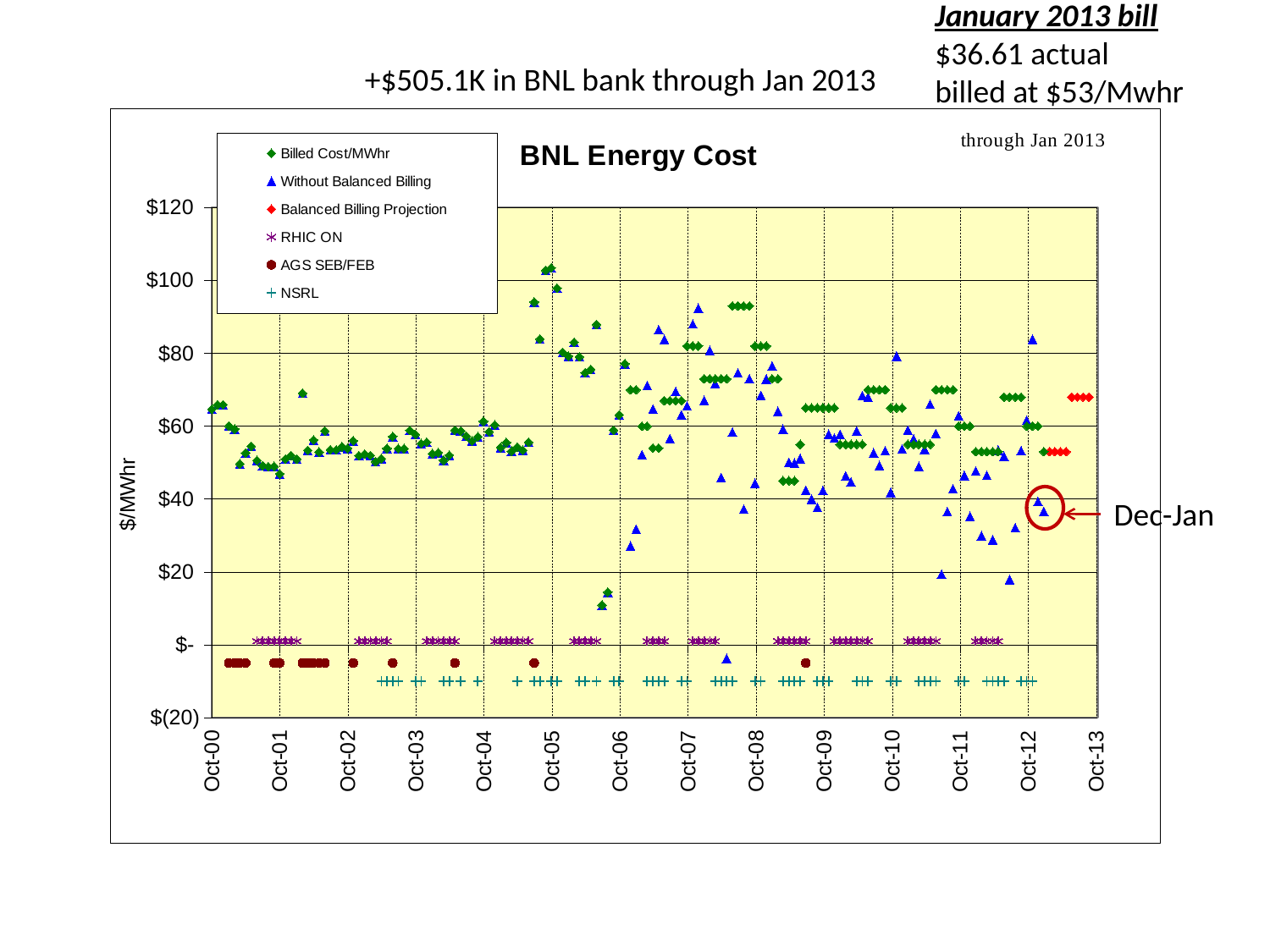
How many series does the chart legend list? 6 Is the Billed Cost/MWhr value larger at Oct-00 or at Oct-05? Oct-05 What is the label on the vertical axis of the chart? $/MWhr Is the lowest Billed Cost/MWhr point, near Oct-06, greater or less than $20? less Which series is plotted at the lowest values on the chart? NSRL How many year labels are shown along the x axis, from Oct-00 to Oct-13? 14 What kind of chart is shown on the slide? Scatter chart Is the highest Billed Cost/MWhr value, near Oct-05, greater or less than $100? greater What is the title of the chart? BNL Energy Cost Do the Billed Cost/MWhr values rise or fall between Oct-04 and Oct-05? rise Is the circled Dec-Jan Without Balanced Billing point near Oct-12 greater or less than $60? less